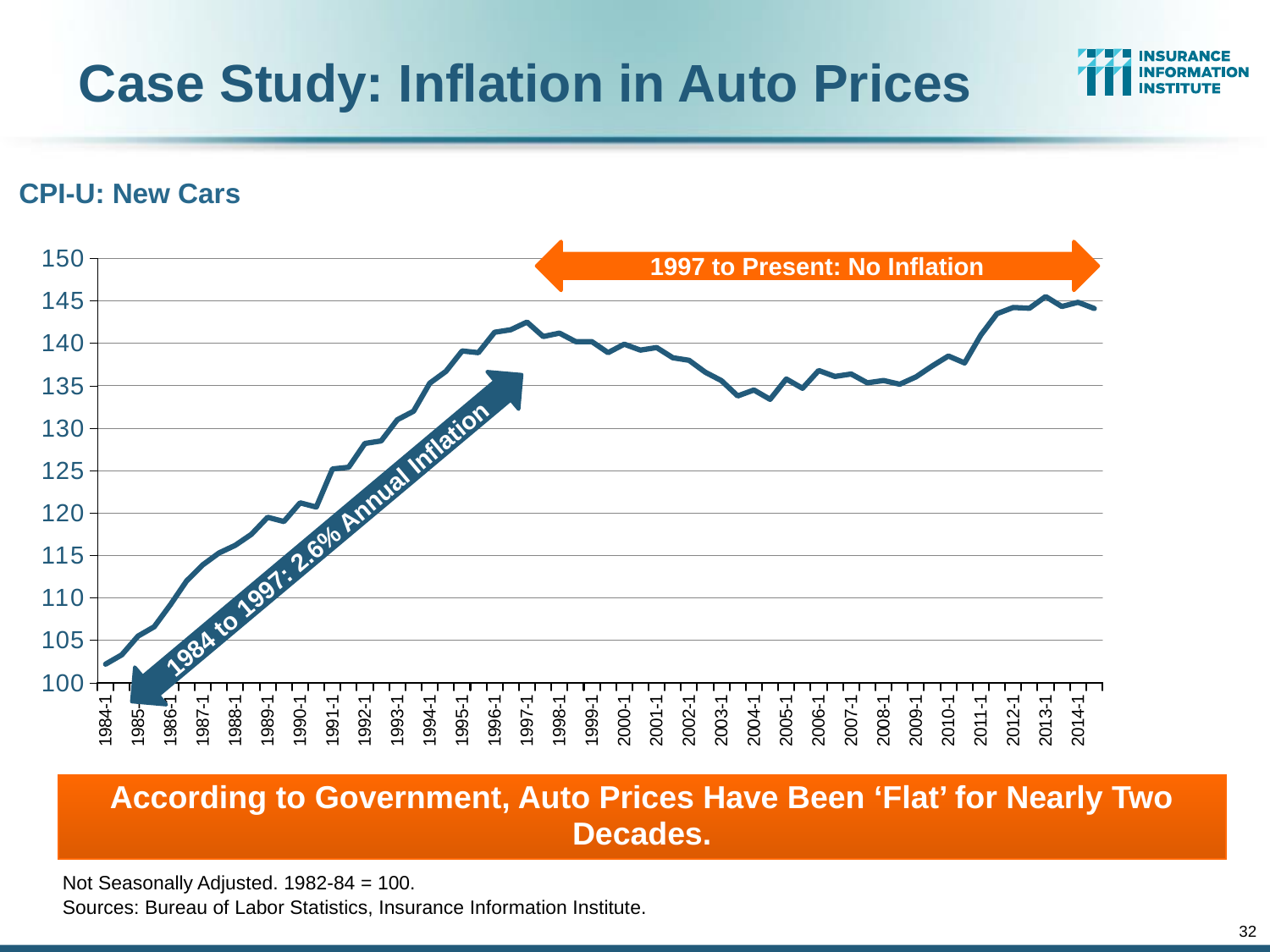
Do the values rise or fall along the x axis from 1984-1 to 1997-1? rise Is the value for 2009-1 greater or less than 140? less Is the value for 1997-1 greater or less than 140? greater Is the value for 1984-1 greater or less than 105? less How many year labels are shown on the x axis? 31 What kind of chart is shown on the slide? line chart According to the annotation on the chart, what was the annual inflation rate from 1984 to 1997? 2.6% Which x-axis label has the lowest value on the chart? 1984-1 What is the title of the chart? CPI-U: New Cars